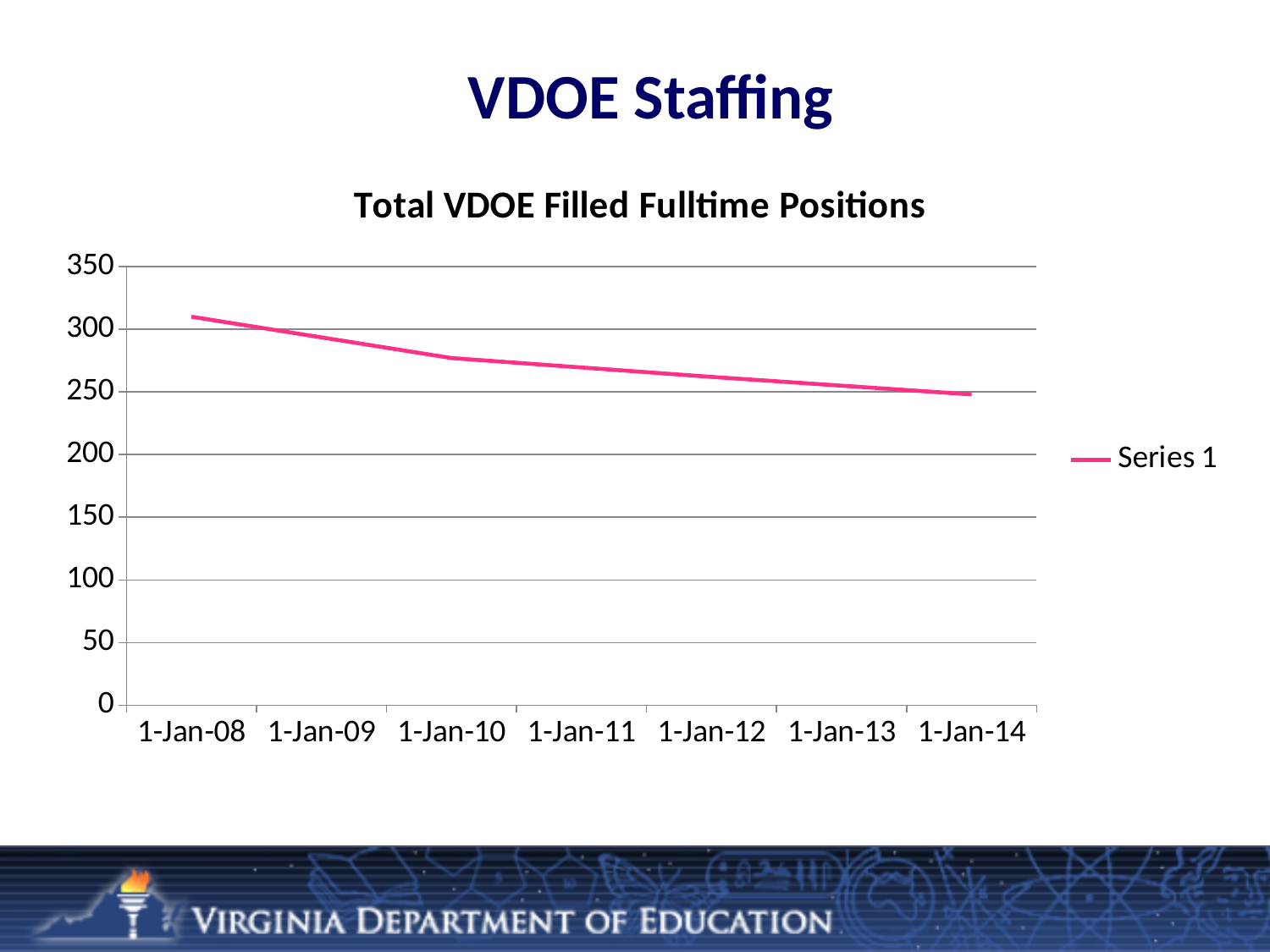
What kind of chart is shown on the slide? line chart What is the name of the series shown in the legend? Series 1 How many dates are shown on the x axis? 7 How many series does the legend list? 1 Is the value for 1-Jan-14 greater or less than 300? less Which date has the highest value? 1-Jan-08 What is the title of the chart? Total VDOE Filled Fulltime Positions Which date has the lowest value? 1-Jan-14 Is the value for 1-Jan-10 greater or less than 250? greater Which is larger, the value for 1-Jan-08 or the value for 1-Jan-14? 1-Jan-08 Is the value for 1-Jan-08 greater or less than 300? greater Do the values rise or fall from 1-Jan-08 to 1-Jan-14? fall